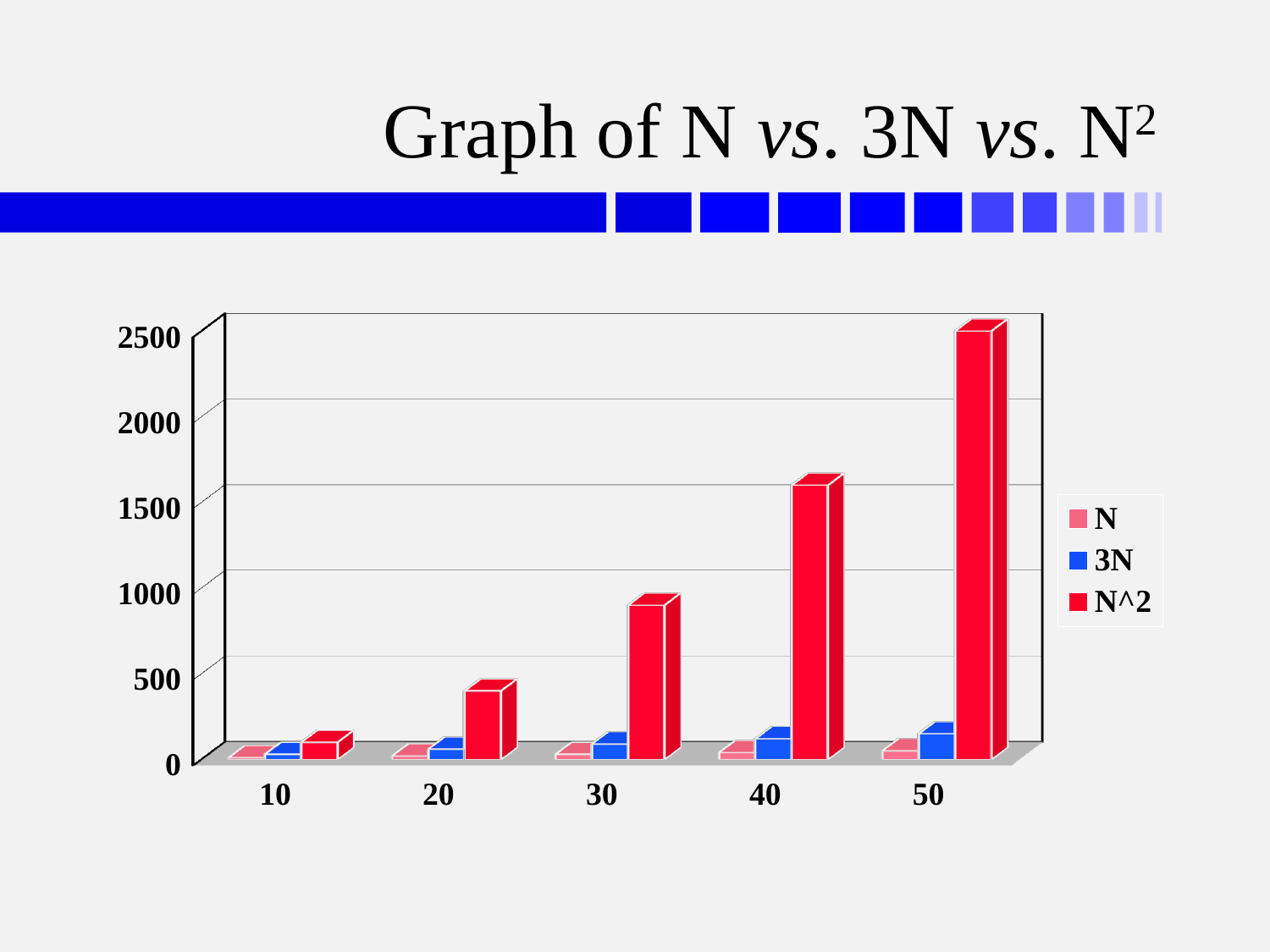
For which x-axis category is the N^2 bar the tallest? 50 For which x-axis category is the N^2 bar the shortest? 10 What colour are the N^2 bars? red Is the N^2 value at 20 greater or less than 500? less How many categories are shown along the x axis? 5 What kind of chart is shown on the slide? bar chart How many series does the legend list? 3 Which is larger, the N^2 value at 50 or the N^2 value at 40? N^2 at 50 Do the N^2 values rise or fall as the x-axis values increase from 10 to 50? rise Is the N^2 value at 30 greater or less than 1500? less Is the N^2 value at 50 greater or less than 2000? greater Which is larger at x = 50, the 3N value or the N value? 3N